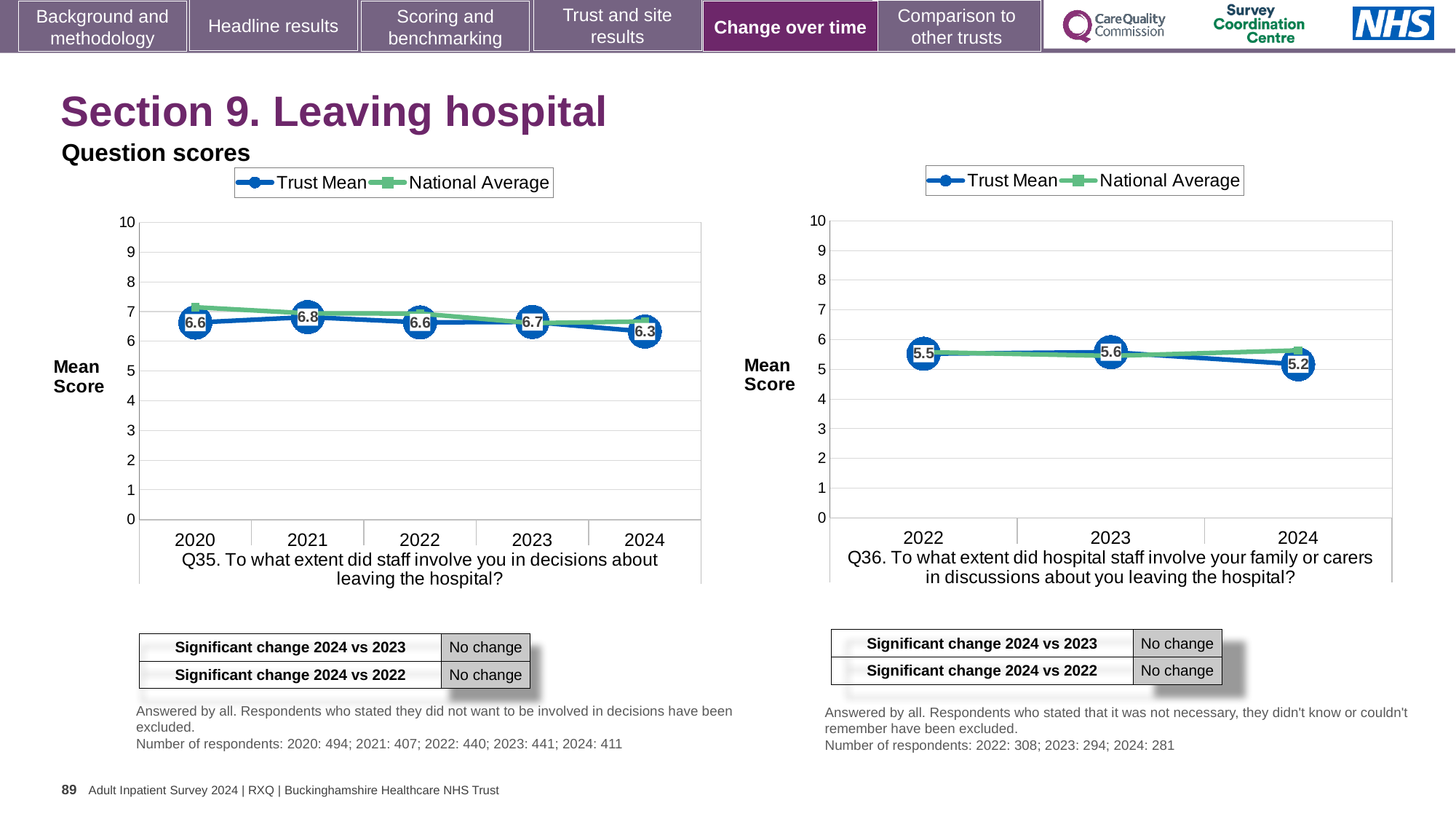
In the Q35 chart on the left, what is the difference between the Trust Mean scores for 2021 and 2024? 0.5 In the Q36 chart on the right, is the National Average value for 2024 greater or less than 5? greater In the Q35 chart on the left, which year has the highest Trust Mean score? 2021 In the Q36 chart on the right, which year has the larger Trust Mean score, 2022 or 2024? 2022 In the Q36 chart on the right, what is the Trust Mean score for 2023? 5.6 How many series does the legend of the Q36 chart on the right list? 2 In the Q35 chart on the left, what is the Trust Mean score for 2021? 6.8 What kind of chart is the Q35 chart on the left? Line chart In the Q35 chart on the left, what is the Trust Mean score for 2024? 6.3 In the Q36 chart on the right, which year has the lowest Trust Mean score? 2024 How many years are plotted in the Q35 chart on the left? 5 In the Q35 chart on the left, which year has the lowest Trust Mean score? 2024